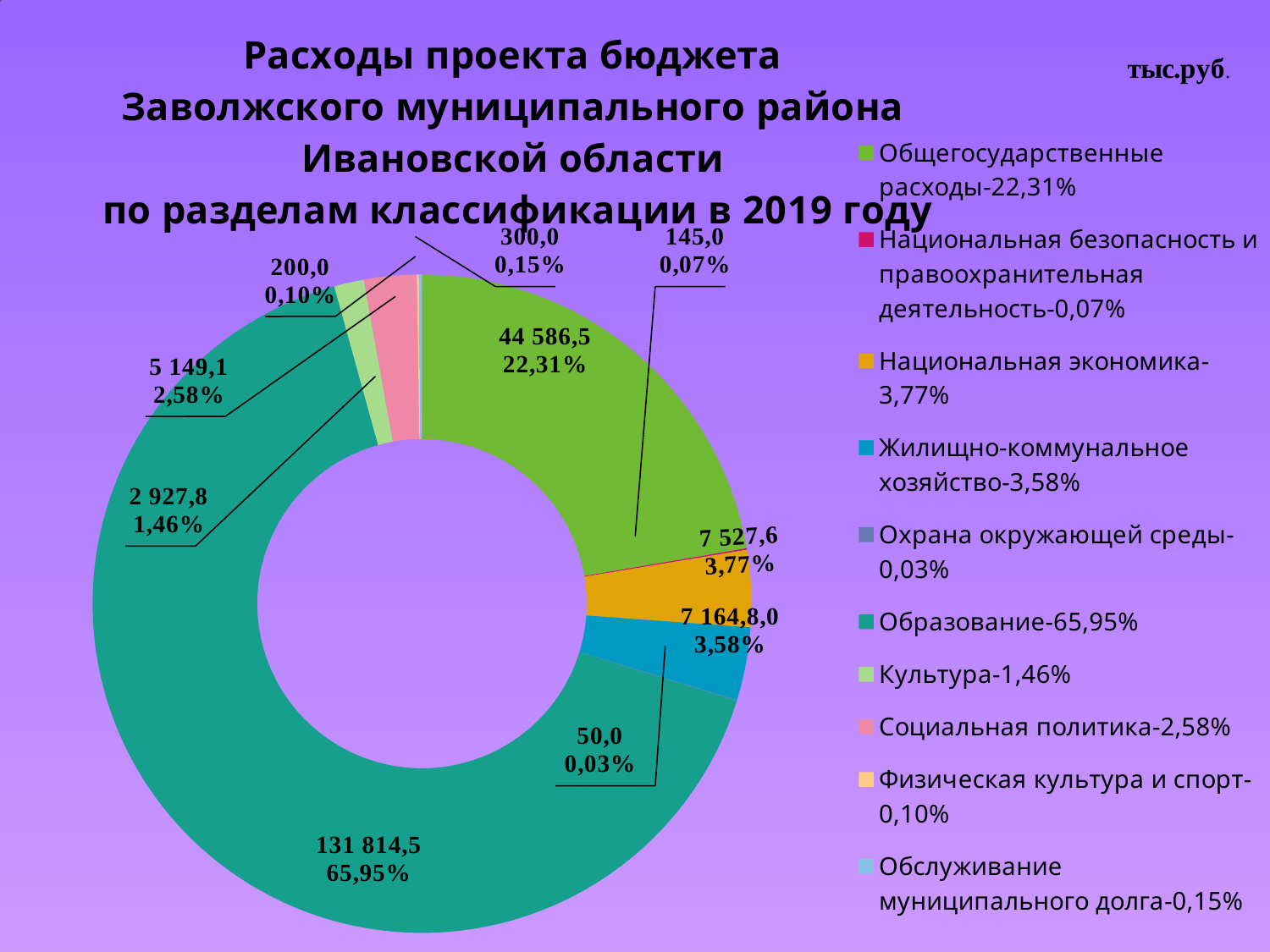
How many categories (sections) does the chart show? 10 Which is larger: the value for Национальная экономика or the value for Жилищно-коммунальное хозяйство? Национальная экономика What is the value for Образование? 131 814,5 In what units are the values on the chart given? тыс.руб. What is the value for Национальная экономика? 7 527,6 Which category has the largest share of expenditures? Образование What share of the total does Культура account for? 1,46% What is the value for Общегосударственные расходы? 44 586,5 Which category has the smallest share of expenditures? Охрана окружающей среды What is the difference between the values for Образование and Общегосударственные расходы? 87 228,0 What kind of chart is shown on the slide? Doughnut (pie) chart What share of the total does Социальная политика account for? 2,58%